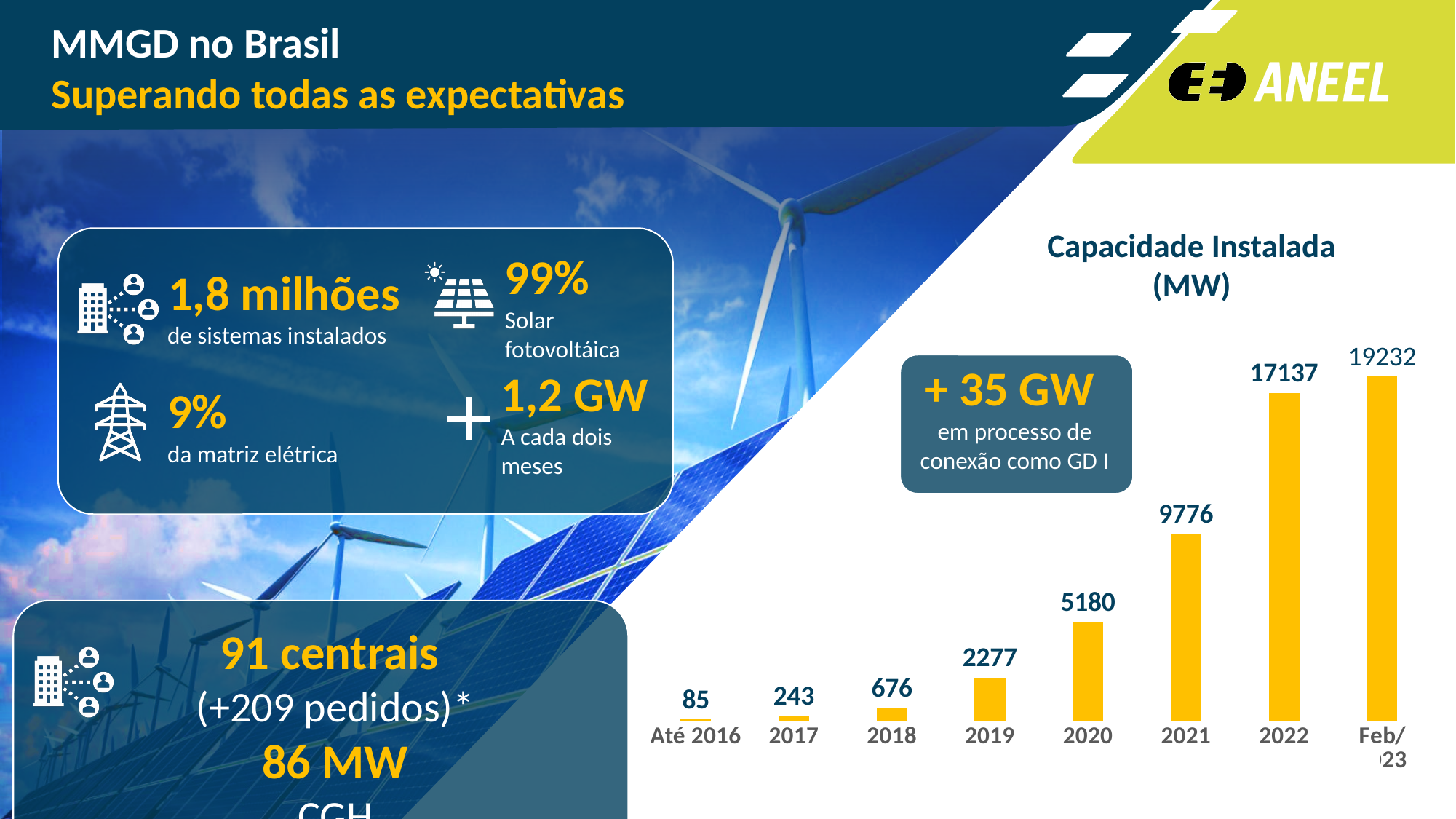
What value does the Capacidade Instalada (MW) chart show for 2018? 676 How many bars (categories) are shown in the Capacidade Instalada (MW) chart? 8 What is the title of the chart on the right side of the slide? Capacidade Instalada (MW) In the Capacidade Instalada (MW) chart, how much higher is the Feb/23 value than the 2022 value? 2095 What is the installed capacity value shown for 2020 in the Capacidade Instalada (MW) chart? 5180 Do the values in the Capacidade Instalada (MW) chart rise or fall from 'Até 2016' to Feb/23? rise In the Capacidade Instalada (MW) chart, which is larger: the value for 2019 or the value for 2020? 2020 What type of chart is the Capacidade Instalada (MW) chart? bar chart Which category has the highest value in the Capacidade Instalada (MW) chart? Feb/23 What is the value labelled for 'Até 2016' in the Capacidade Instalada (MW) chart? 85 In the Capacidade Instalada (MW) chart, what is the difference between the 2022 value and the 2021 value? 7361 Which category has the lowest value in the Capacidade Instalada (MW) chart? Até 2016